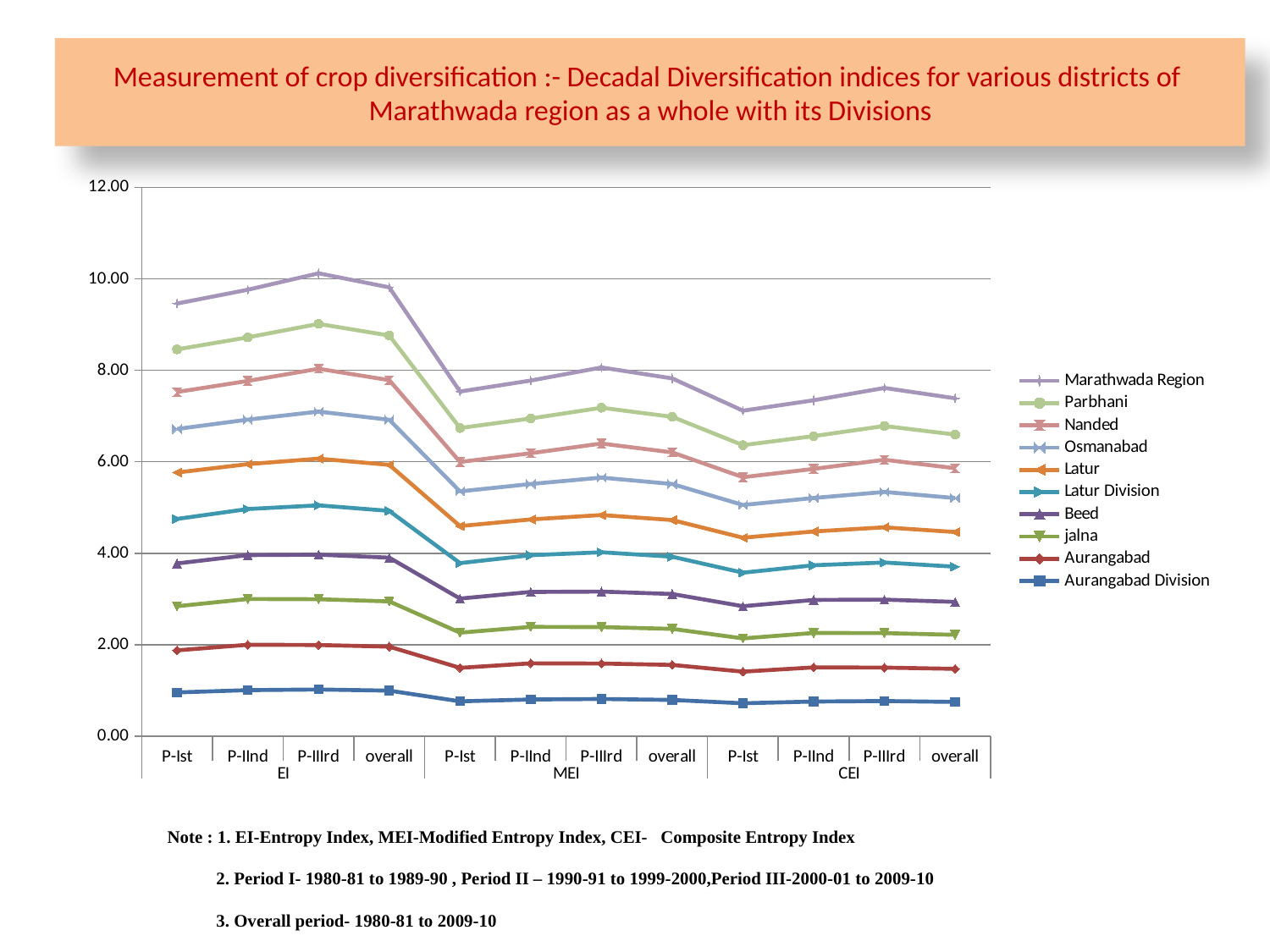
Is the value for Latur at MEI P-Ist greater or less than 6.00? less Which is larger at EI P-Ist, Parbhani or Nanded? Parbhani Is the value for Beed at MEI P-Ist greater or less than 4.00? less Which series has the highest values across the chart? Marathwada Region Do the Marathwada Region values rise or fall from EI P-Ist to EI P-IIIrd? rise How many points are plotted along the x axis for each series? 12 According to the note, what does MEI stand for? Modified Entropy Index What kind of chart is shown on the slide? line chart How many series does the legend list? 10 How many index groups (EI, MEI, CEI) are shown on the x axis? 3 Is the value for Marathwada Region at EI P-Ist greater or less than 8.00? greater Which series has the lowest values across the chart? Aurangabad Division